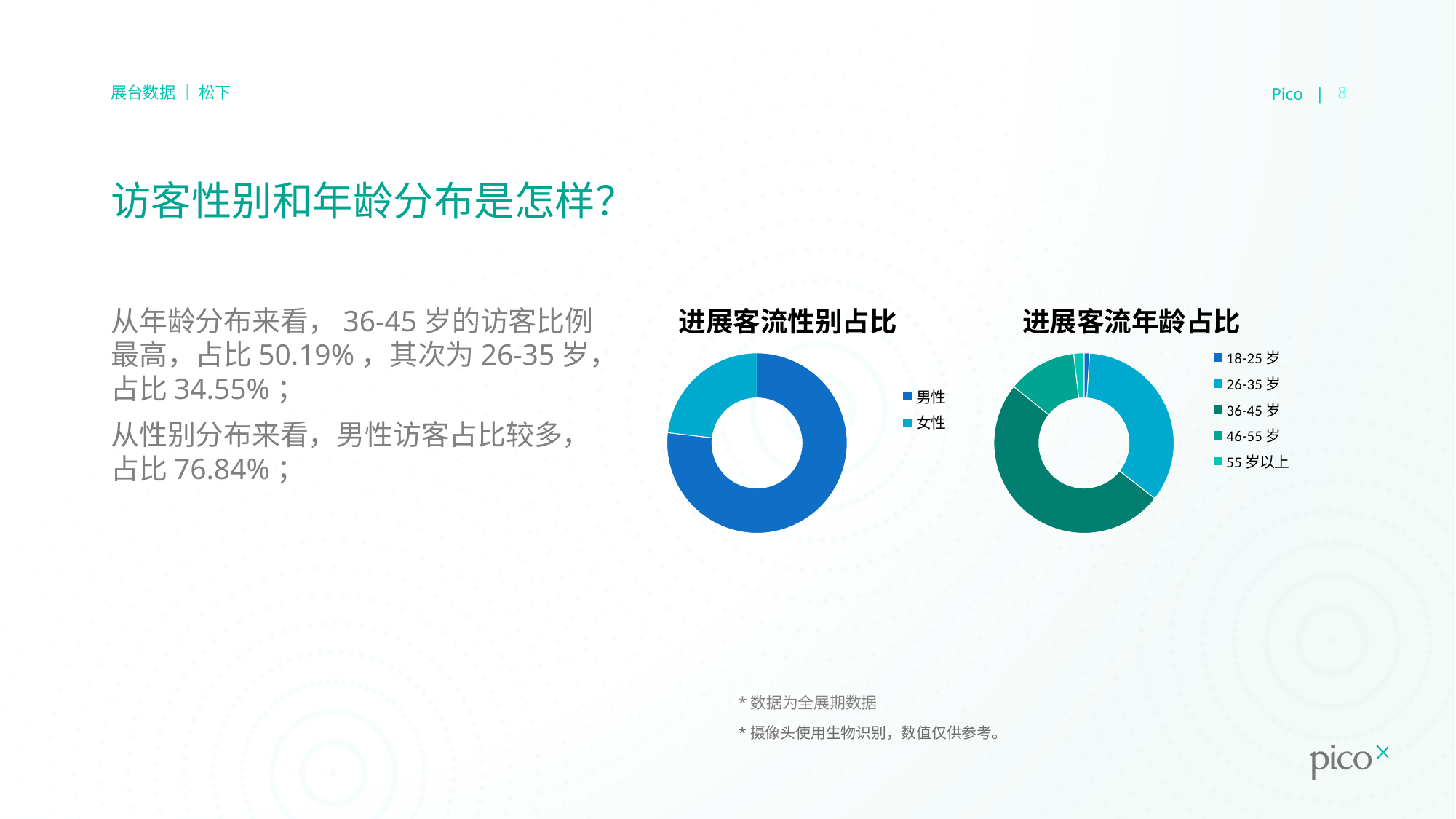
What is the title of the chart on the right side of the slide? 进展客流年龄占比 In the 进展客流性别占比 chart, which category has the largest slice? 男性 In the 进展客流年龄占比 chart, which age group has the largest slice? 36-45 岁 How many age categories does the 进展客流年龄占比 chart show? 5 According to the slide, what share of visitors in the 进展客流年龄占比 chart are aged 36-45 岁? 50.19% In the 进展客流年龄占比 chart, by how many percentage points does the 36-45 岁 share exceed the 26-35 岁 share? 15.64% What kind of chart is the 进展客流性别占比 chart? Doughnut chart How many entries does the legend of the 进展客流性别占比 chart list? 2 According to the slide, what share of visitors in the 进展客流性别占比 chart are 男性? 76.84% According to the slide, what share of visitors in the 进展客流年龄占比 chart are aged 26-35 岁? 34.55% In the 进展客流年龄占比 chart, which slice is larger, 26-35 岁 or 46-55 岁? 26-35 岁 In the 进展客流年龄占比 chart, which slice is larger, 36-45 岁 or 26-35 岁? 36-45 岁